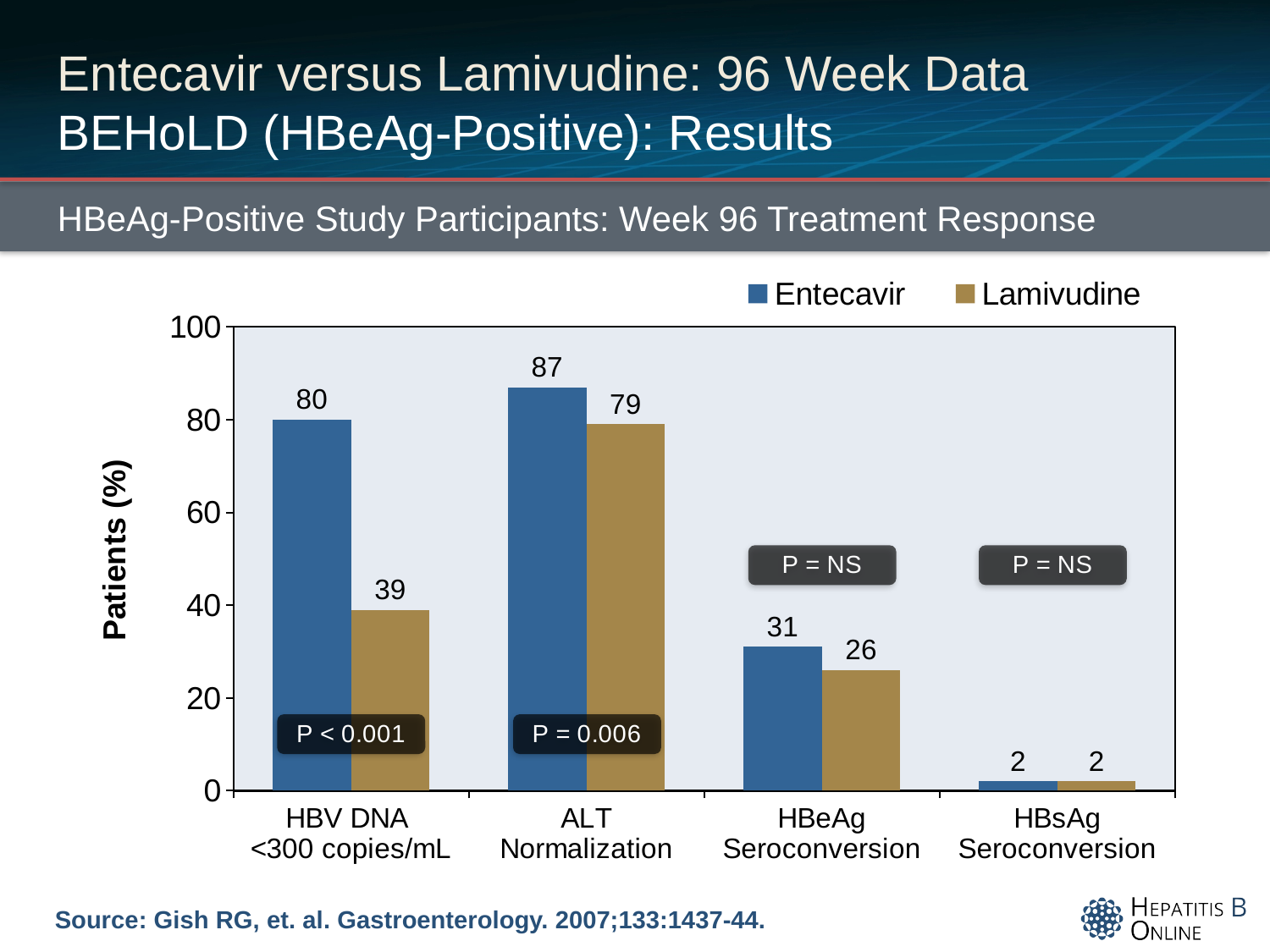
Is the Lamivudine value for HBV DNA <300 copies/mL greater or less than 40? less How many categories are shown on the x axis? 4 What is the value for Lamivudine in the ALT Normalization category? 79 What is the value for Entecavir in the HBV DNA <300 copies/mL category? 80 Which category has the lowest Lamivudine value? HBsAg Seroconversion What is the value for Lamivudine in the HBeAg Seroconversion category? 26 Which is larger in the HBeAg Seroconversion category, Entecavir or Lamivudine? Entecavir How many series does the legend list? 2 What is the difference between the Entecavir and Lamivudine values for HBV DNA <300 copies/mL? 41 What is the label of the y axis? Patients (%) Which category has the highest Entecavir value? ALT Normalization What kind of chart is shown on the slide? bar chart